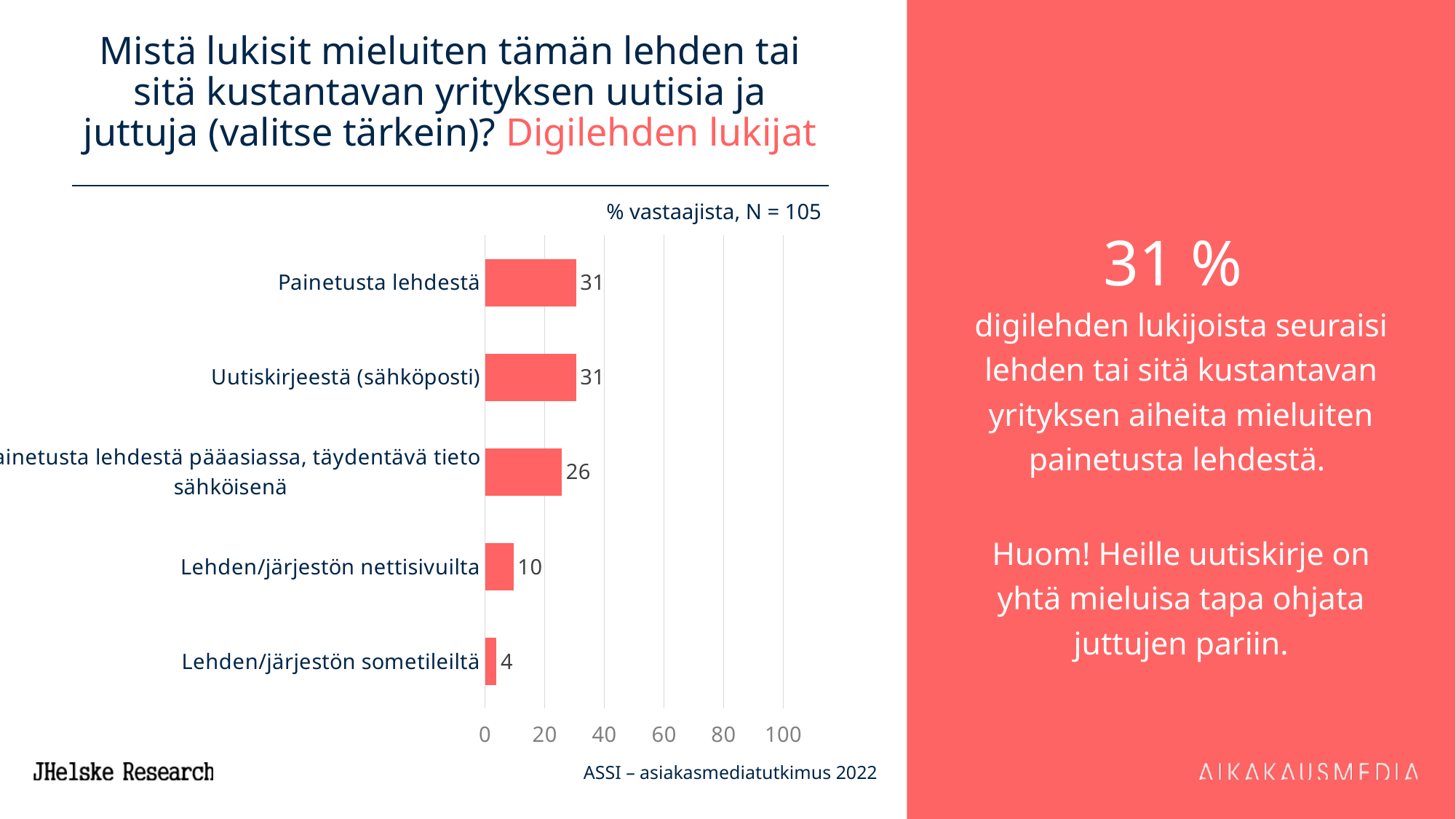
How many categories are shown in the chart? 5 What value is shown for the category ending in 'täydentävä tieto sähköisenä'? 26 Is the value for Uutiskirjeestä (sähköposti) greater or less than 20? greater What is the sample size (N) stated above the chart? 105 What is the difference between the values for Painetusta lehdestä and Lehden/järjestön nettisivuilta? 21 What value is shown for Lehden/järjestön sometileiltä? 4 Which category has the lowest value? Lehden/järjestön sometileiltä Which is larger, the value for Lehden/järjestön nettisivuilta or the value for Lehden/järjestön sometileiltä? Lehden/järjestön nettisivuilta What value is shown for Painetusta lehdestä? 31 What value is shown for Lehden/järjestön nettisivuilta? 10 What kind of chart is shown on the slide? bar chart What value is shown for Uutiskirjeestä (sähköposti)? 31